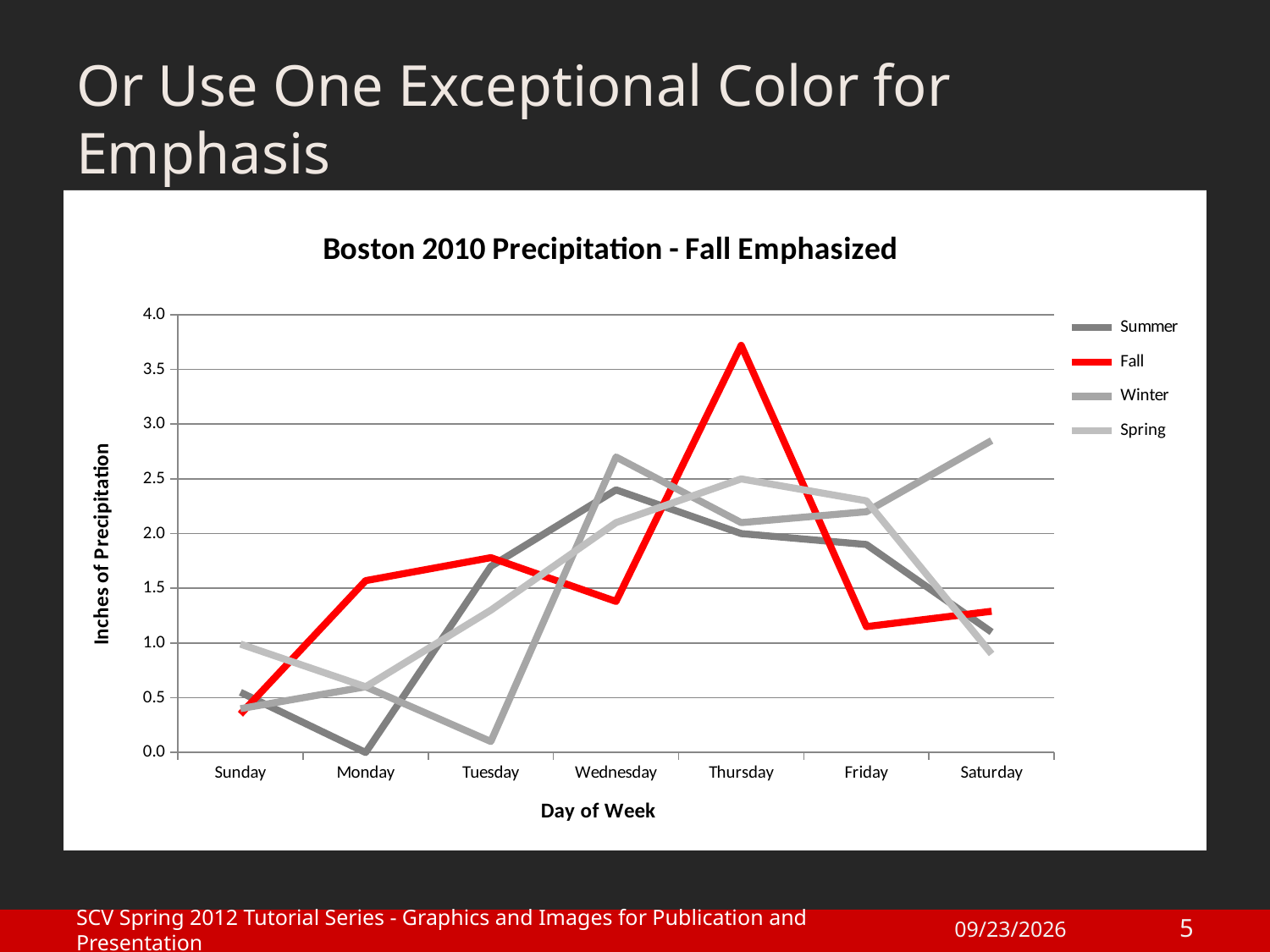
Which series is drawn in red? Fall Does the Winter series rise or fall from Thursday to Saturday? rise Is the Winter value on Saturday greater or less than 2.5? greater Is the Spring value on Tuesday greater or less than 0.5? greater Is the Fall value on Friday greater or less than 1.5? less How many series does the legend list? 4 What kind of chart is shown on the slide? line chart On Thursday, which series has the larger value, Fall or Summer? Fall On which day does the Summer series reach its lowest value? Monday How many days of the week are plotted along the x axis? 7 On which day does the Fall series reach its highest value? Thursday